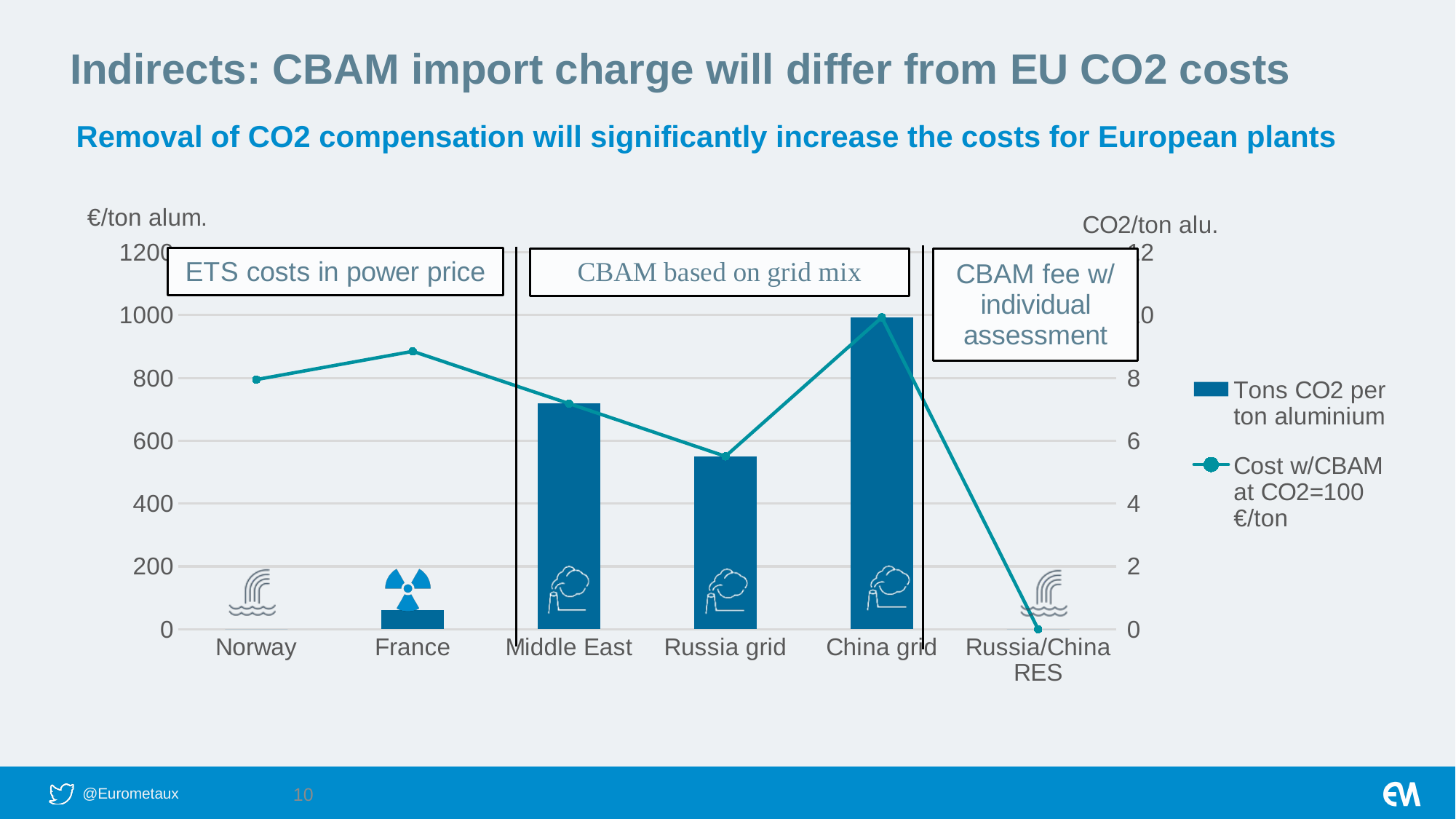
Is the Tons CO2 per ton aluminium bar for China grid greater or less than 8? greater Is the Tons CO2 per ton aluminium bar for Russia grid greater or less than 6? less Which has the larger Tons CO2 per ton aluminium bar, Middle East or Russia grid? Middle East Is the Cost w/CBAM at CO2=100 €/ton value for Norway greater or less than 600? greater Which category has the highest bar for Tons CO2 per ton aluminium? China grid Which category has the highest point on the Cost w/CBAM at CO2=100 €/ton line? China grid What is the label of the left vertical axis of the chart? €/ton alum. How many categories are shown on the x axis of the chart? 6 What kind of chart is shown on the slide? bar and line chart Which category has the lowest point on the Cost w/CBAM at CO2=100 €/ton line? Russia/China RES How many series does the chart legend list? 2